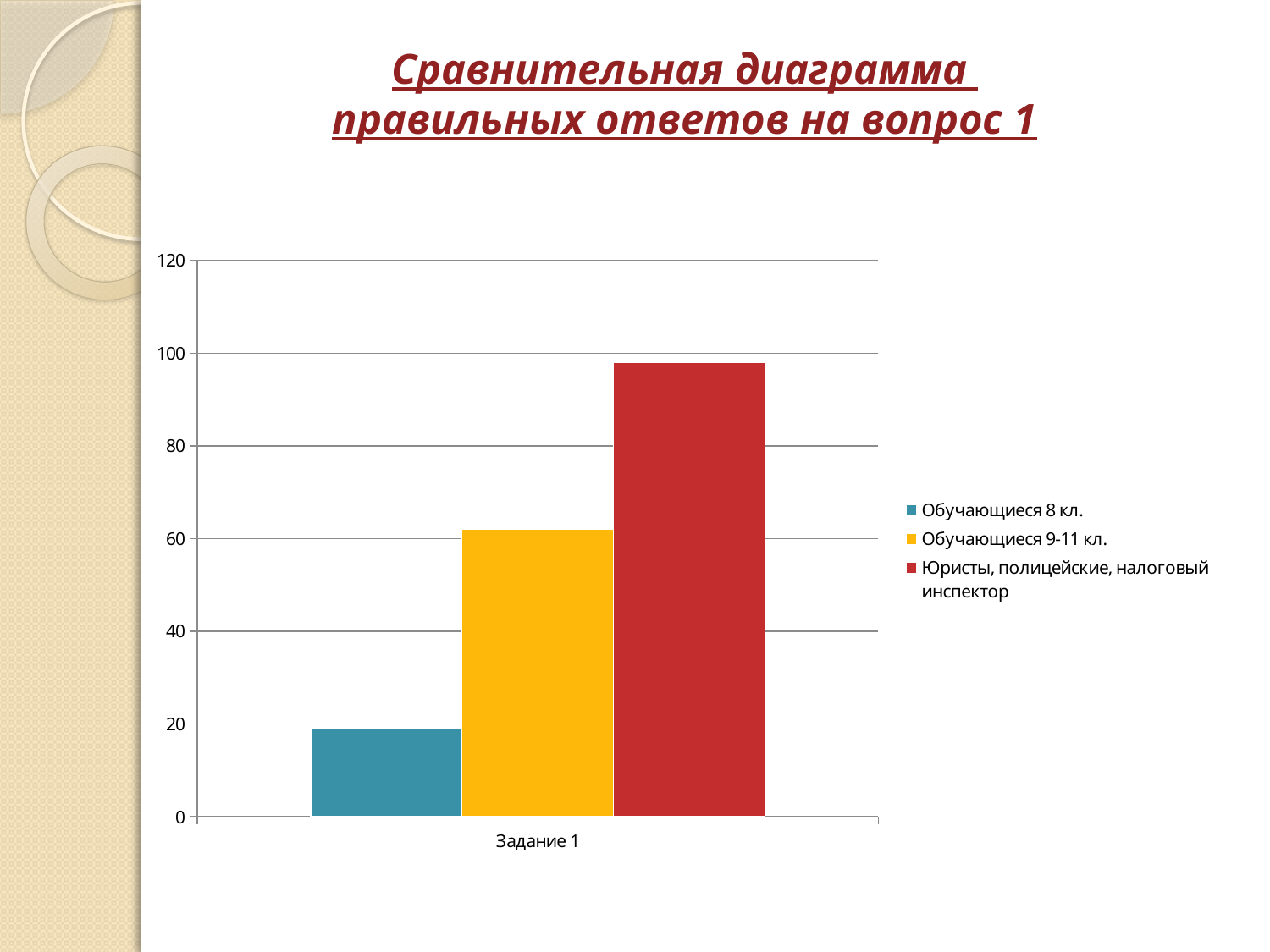
Is the value for Обучающиеся 9-11 кл. greater or less than 80? less What is the title of the chart on the slide? Сравнительная диаграмма правильных ответов на вопрос 1 Is the value for Юристы, полицейские, налоговый инспектор greater or less than 80? greater Which is larger for Задание 1: the value for Обучающиеся 9-11 кл. or the value for Обучающиеся 8 кл.? Обучающиеся 9-11 кл. How many categories are shown on the x axis? 1 Is the value for Обучающиеся 8 кл. greater or less than 40? less Which series has the lowest bar for Задание 1? Обучающиеся 8 кл. What is the label of the category on the x axis? Задание 1 Which series has the highest bar for Задание 1? Юристы, полицейские, налоговый инспектор How many series does the legend list? 3 What kind of chart is shown on the slide? bar chart